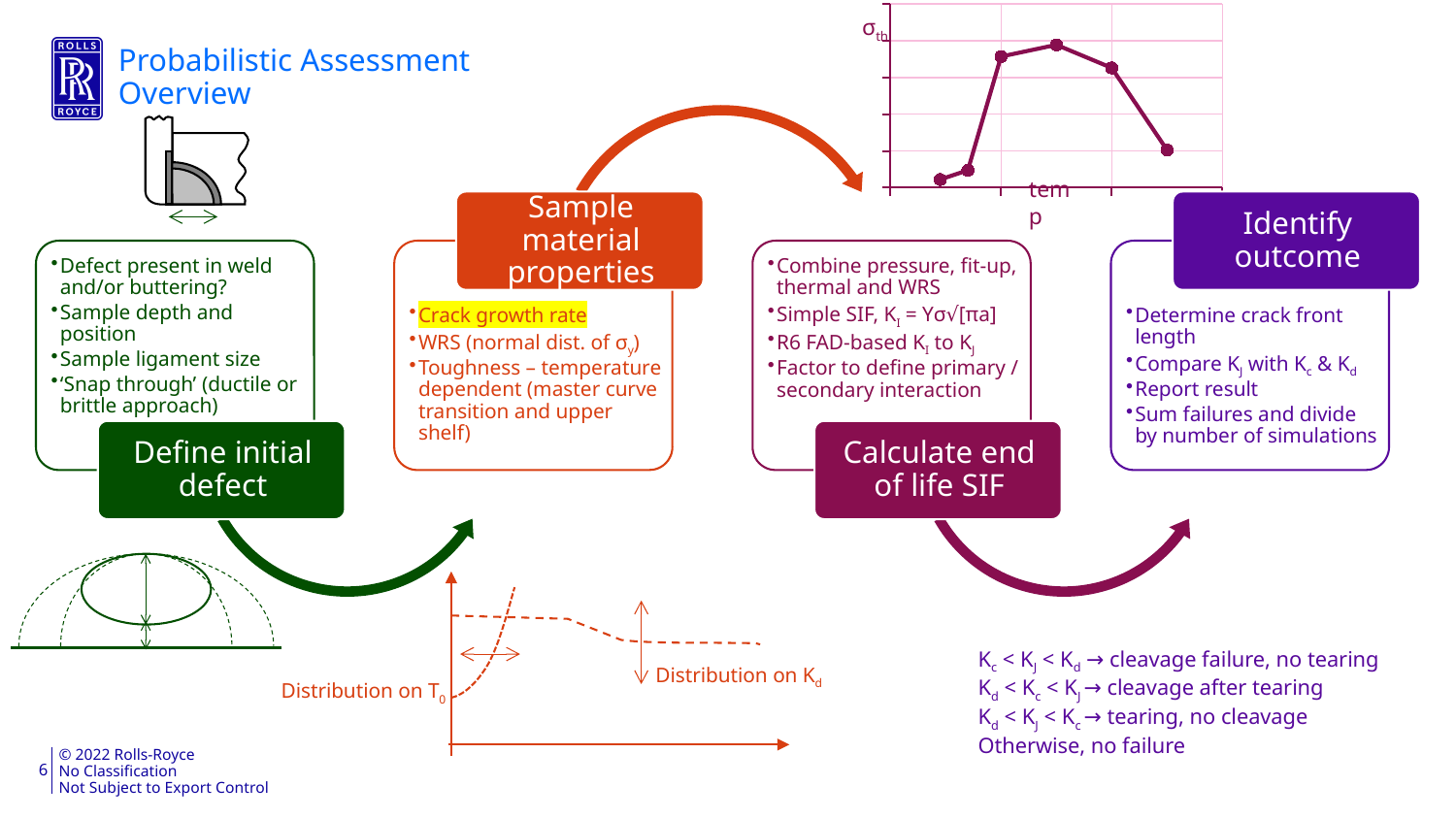
What kind of chart is shown at the top right of the slide? line chart On the chart at the top right, do the values rise or fall from the second point to the third point? rise On the chart at the top right, which is higher: the fourth point or the last point? the fourth point How many lines are plotted on the chart at the top right? 1 How many data points are plotted on the line chart at the top right? 6 What is the label on the horizontal axis of the chart at the top right? temp What is the label on the vertical axis of the chart at the top right? σth On the chart at the top right, do the values rise or fall from the fourth point to the last point? fall On the chart at the top right, which point along the x axis has the highest value? the fourth point On the chart at the top right, which is higher: the second point or the third point? the third point